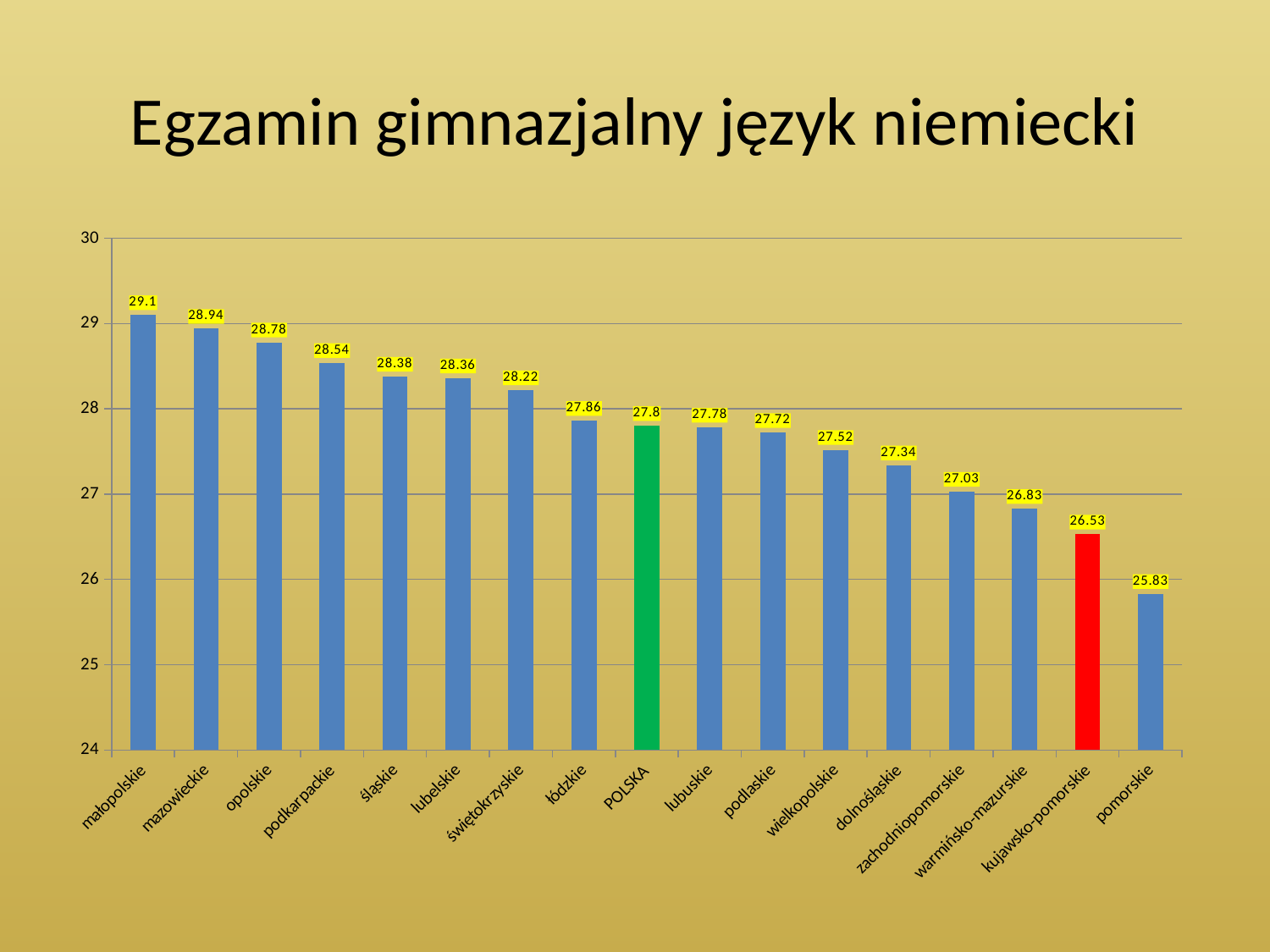
Which is larger, the value for lubuskie or the value for wielkopolskie? lubuskie Is the value for warmińsko-mazurskie greater or less than 27? less Which bar is coloured red? kujawsko-pomorskie How many categories are shown on the x axis? 17 What is the value for małopolskie? 29.1 What is the value for dolnośląskie? 27.34 What is the value for POLSKA? 27.8 What is the value for kujawsko-pomorskie? 26.53 Which category has the lowest value? pomorskie What is the difference between the values for małopolskie and pomorskie? 3.27 What kind of chart is shown on the slide? bar chart Which category has the highest value? małopolskie